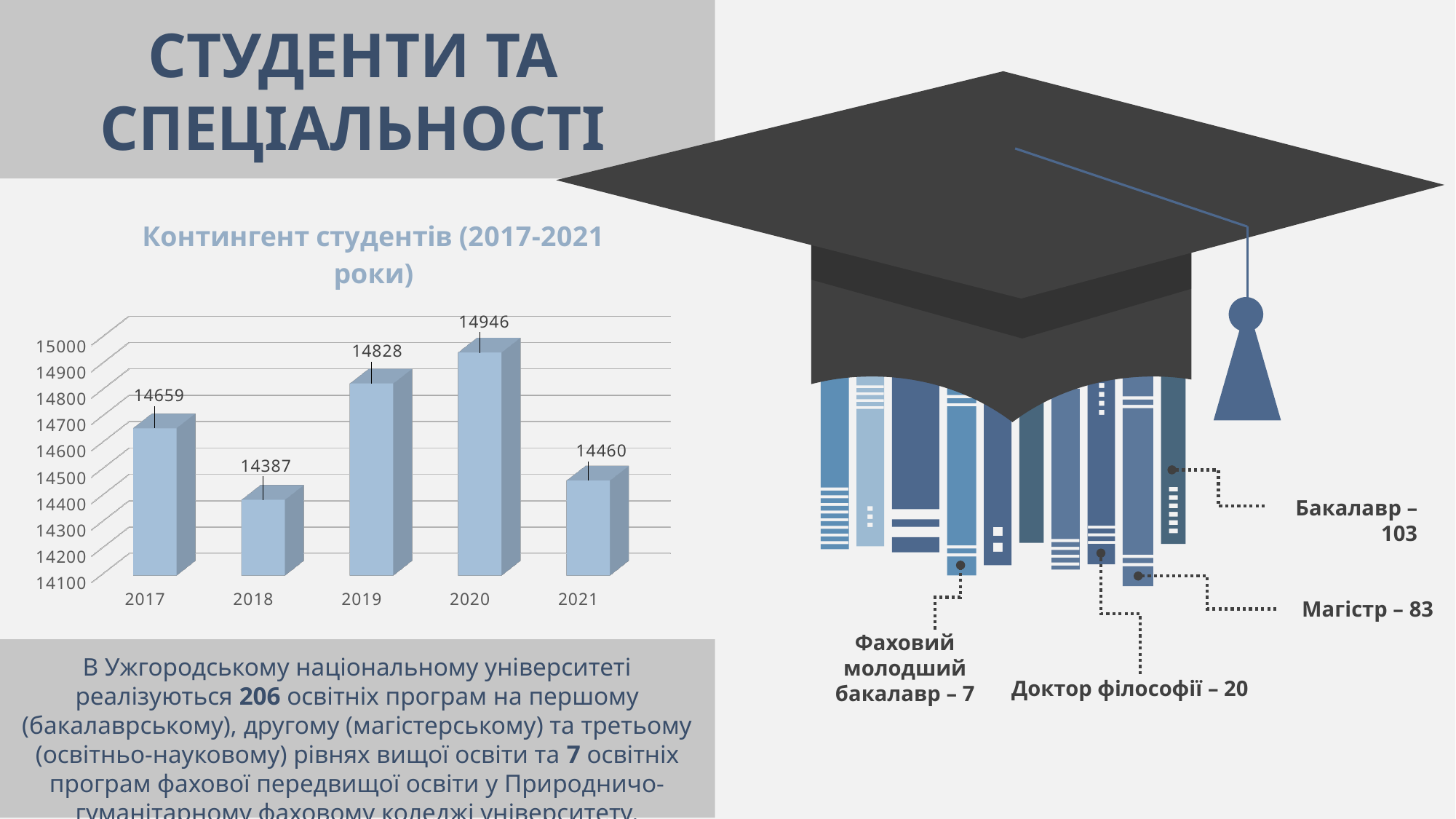
What is the value for 2017 in the chart 'Контингент студентів (2017-2021 роки)'? 14659 Which is larger, the value for 2017 or the value for 2021? 2017 What is the title of the chart on the slide? Контингент студентів (2017-2021 роки) What is the value for 2020 in the chart? 14946 What is the difference between the values for 2020 and 2018? 559 What is the difference between the values for 2019 and 2017? 169 Which year has the lowest value in the chart? 2018 Is the value for 2019 greater or less than 14800? greater What is the value for 2021 in the chart? 14460 Which year has the highest value in the chart? 2020 What kind of chart is shown on the slide? bar chart How many years are shown on the x axis of the chart? 5